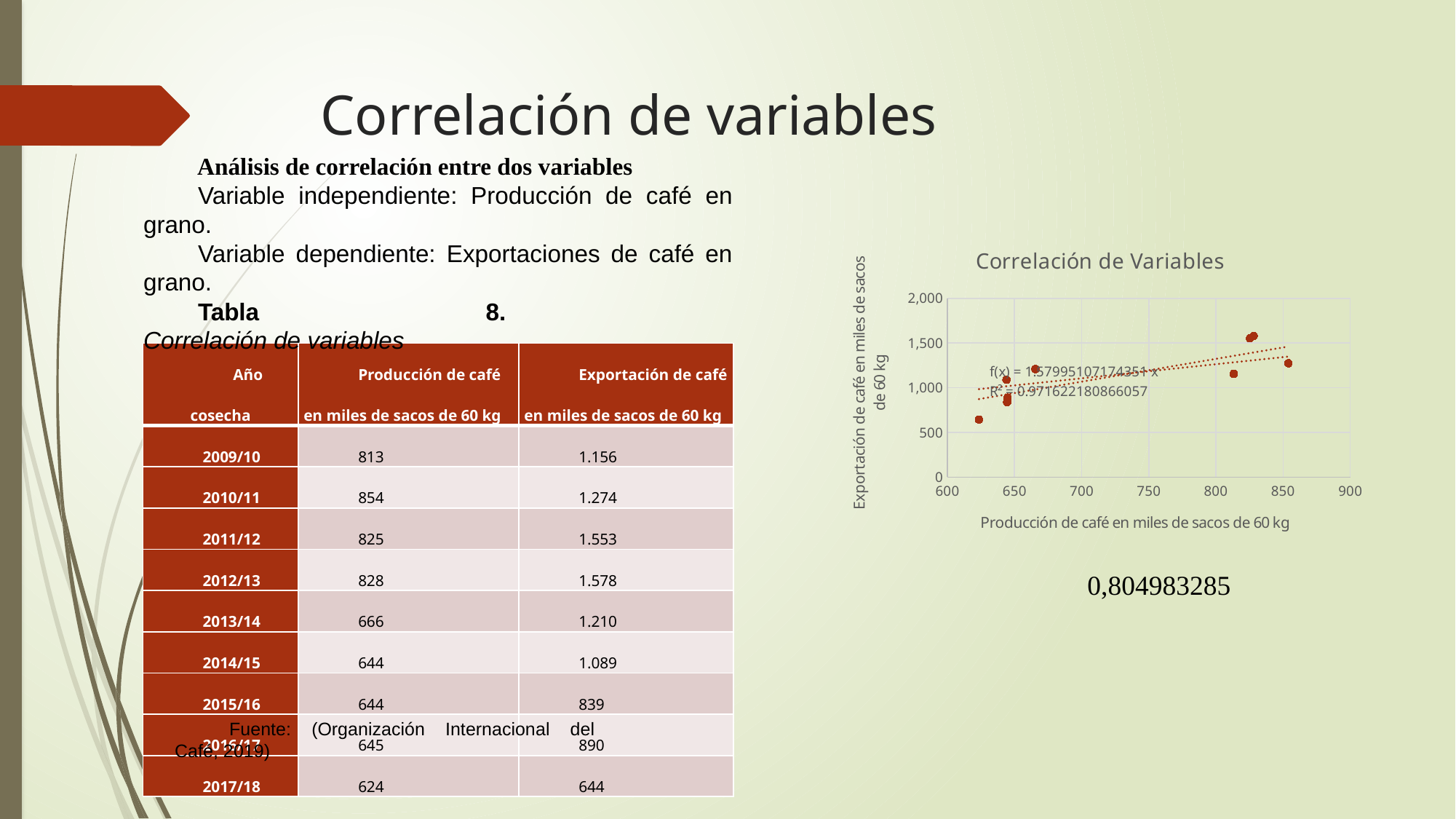
What is the maximum value shown on the x axis of the chart? 900 What is the title of the chart on the slide? Correlación de Variables In the chart, is the export value for the point with the lowest production (around 620) greater or less than 1,000? less What is the maximum value shown on the y axis of the chart? 2,000 What is the label of the x axis of the chart? Producción de café en miles de sacos de 60 kg Do the plotted points in the chart generally rise or fall as production increases along the x axis? rise Which has the higher export value in the chart: the point at production around 825 or the point at production around 625? the point at production around 825 What kind of chart is shown on the slide? scatter chart